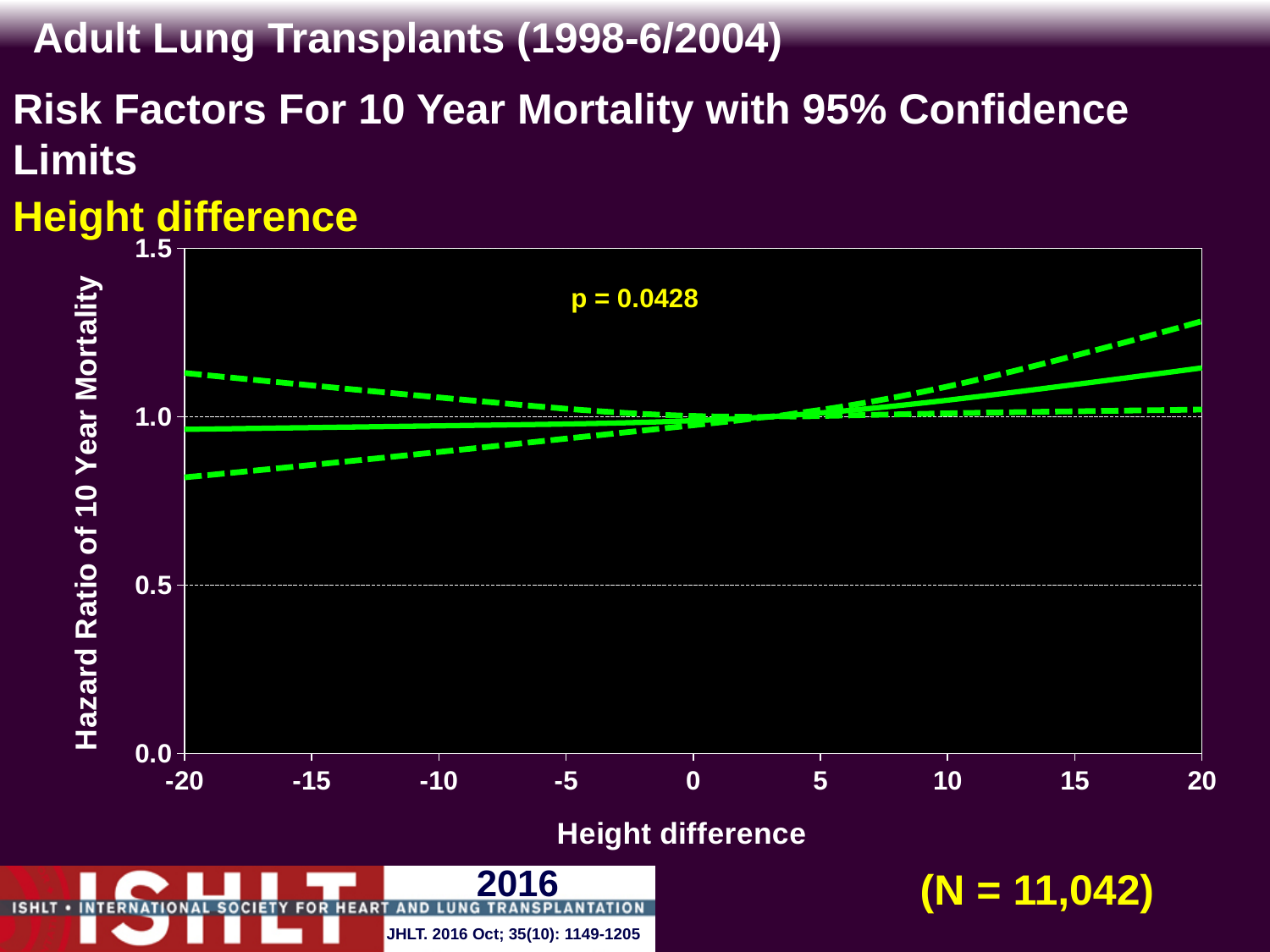
Is the hazard ratio (solid line) at a height difference of 20 greater or less than 1.0? greater Is the hazard ratio (solid line) larger at a height difference of 20 or at -20? 20 Is the hazard ratio (solid line) at a height difference of -20 greater or less than 1.0? less Does the solid hazard ratio line rise or fall as height difference increases from -20 to 20? rise What is the highest value labelled on the y axis? 1.5 What sample size (N) is shown on the slide? N = 11,042 How many lines are plotted on the chart? 3 What kind of chart is shown on the slide? line chart Is the lower confidence limit (lower dashed line) at a height difference of -20 greater or less than 0.5? greater How many tick labels are shown on the x axis? 9 What p-value is printed on the chart? p = 0.0428